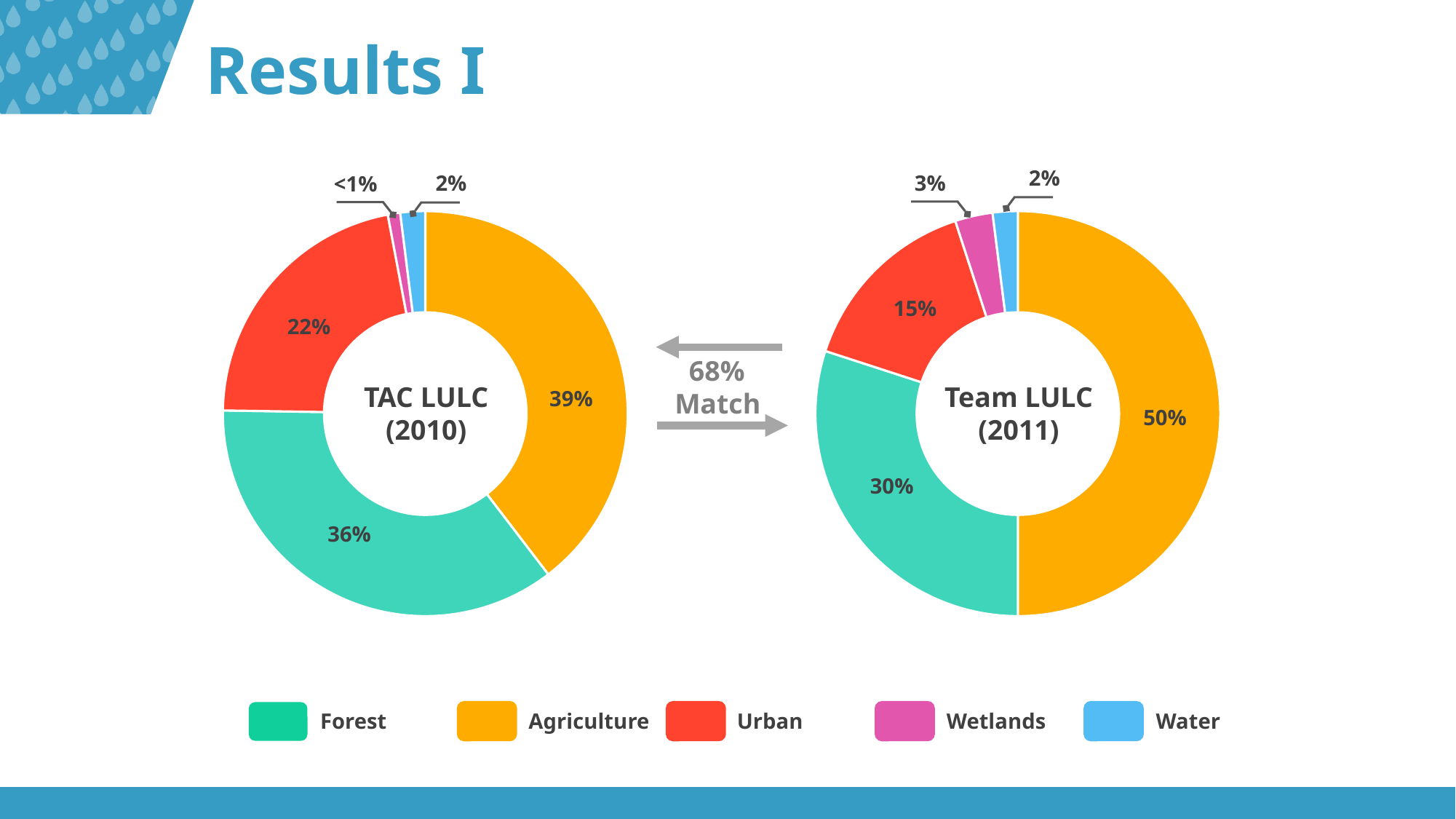
In the Team LULC (2011) chart, what is the difference between the Forest and Urban shares? 15% In the TAC LULC (2010) chart, what percentage is Urban? 22% What is the difference between the Agriculture shares in the Team LULC (2011) chart and the TAC LULC (2010) chart? 11% In the TAC LULC (2010) chart, what percentage is Agriculture? 39% In the Team LULC (2011) chart, what percentage is Wetlands? 3% In the TAC LULC (2010) chart, which category has the smallest share? Wetlands How many categories does the legend list for the charts? 5 What kind of chart is the TAC LULC (2010) chart? Donut (pie) chart In the Team LULC (2011) chart, which category has the largest share? Agriculture What match percentage is shown between the two charts? 68% In the Team LULC (2011) chart, what percentage is Forest? 30% Which chart shows a larger Urban share, TAC LULC (2010) or Team LULC (2011)? TAC LULC (2010)